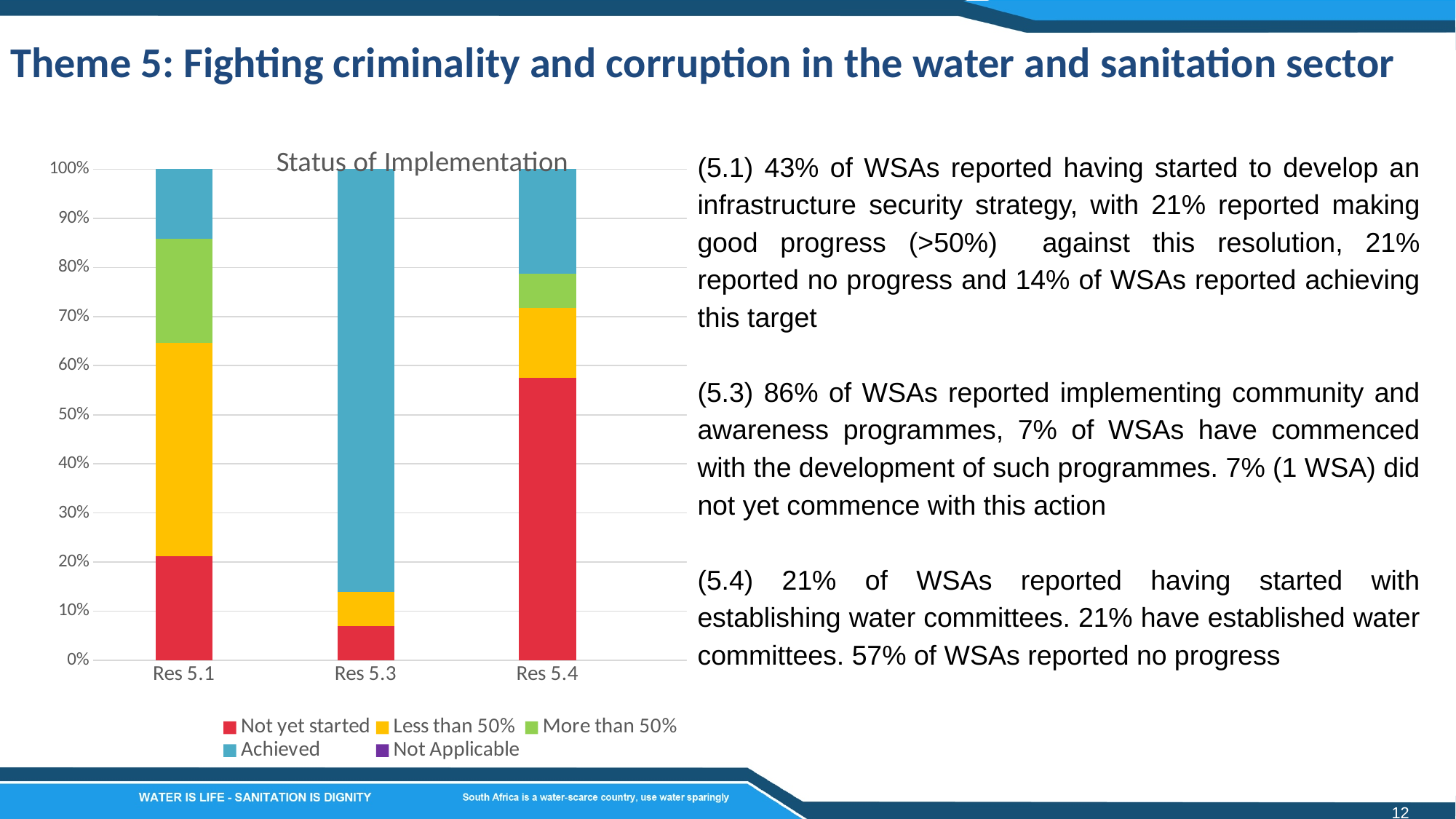
Is the 'Not yet started' value for Res 5.4 greater or less than 50%? greater Which category has the largest 'Not yet started' segment? Res 5.4 What is the title of the chart? Status of Implementation Which has the larger 'Less than 50%' segment, Res 5.1 or Res 5.4? Res 5.1 How many categories are shown on the x axis of the chart? 3 Which category has the largest 'Achieved' segment? Res 5.3 What kind of chart is shown on the slide? Stacked bar chart Which category has the smallest 'Not yet started' segment? Res 5.3 What is the total height of the stacked bar for Res 5.1? 100% How many series does the chart legend list? 5 Is the 'Not yet started' value for Res 5.1 greater or less than 30%? less Is the 'Not yet started' value for Res 5.3 greater or less than 10%? less